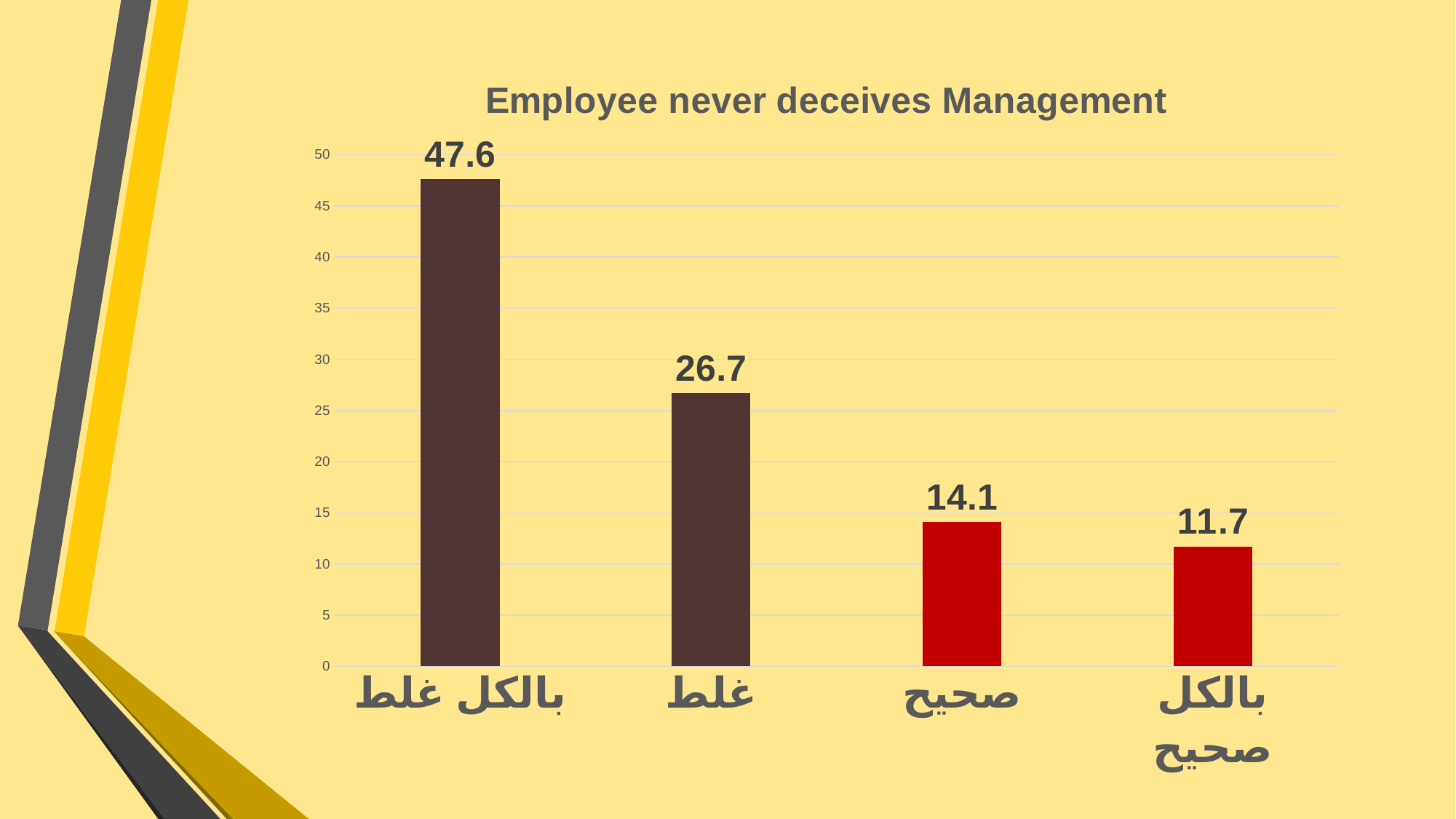
Which category has the highest value? بالكل غلط What is the value for بالكل صحيح? 11.7 What kind of chart is shown on the slide? Bar chart What is the difference between the values for صحيح and بالكل صحيح? 2.4 Which category has the lowest value? بالكل صحيح What is the value for صحيح? 14.1 What is the title of the chart? Employee never deceives Management What is the value for غلط? 26.7 What is the value for بالكل غلط? 47.6 Which is larger, the value for غلط or the value for صحيح? غلط What is the difference between the values for بالكل غلط and غلط? 20.9 How many categories are shown in the chart? 4